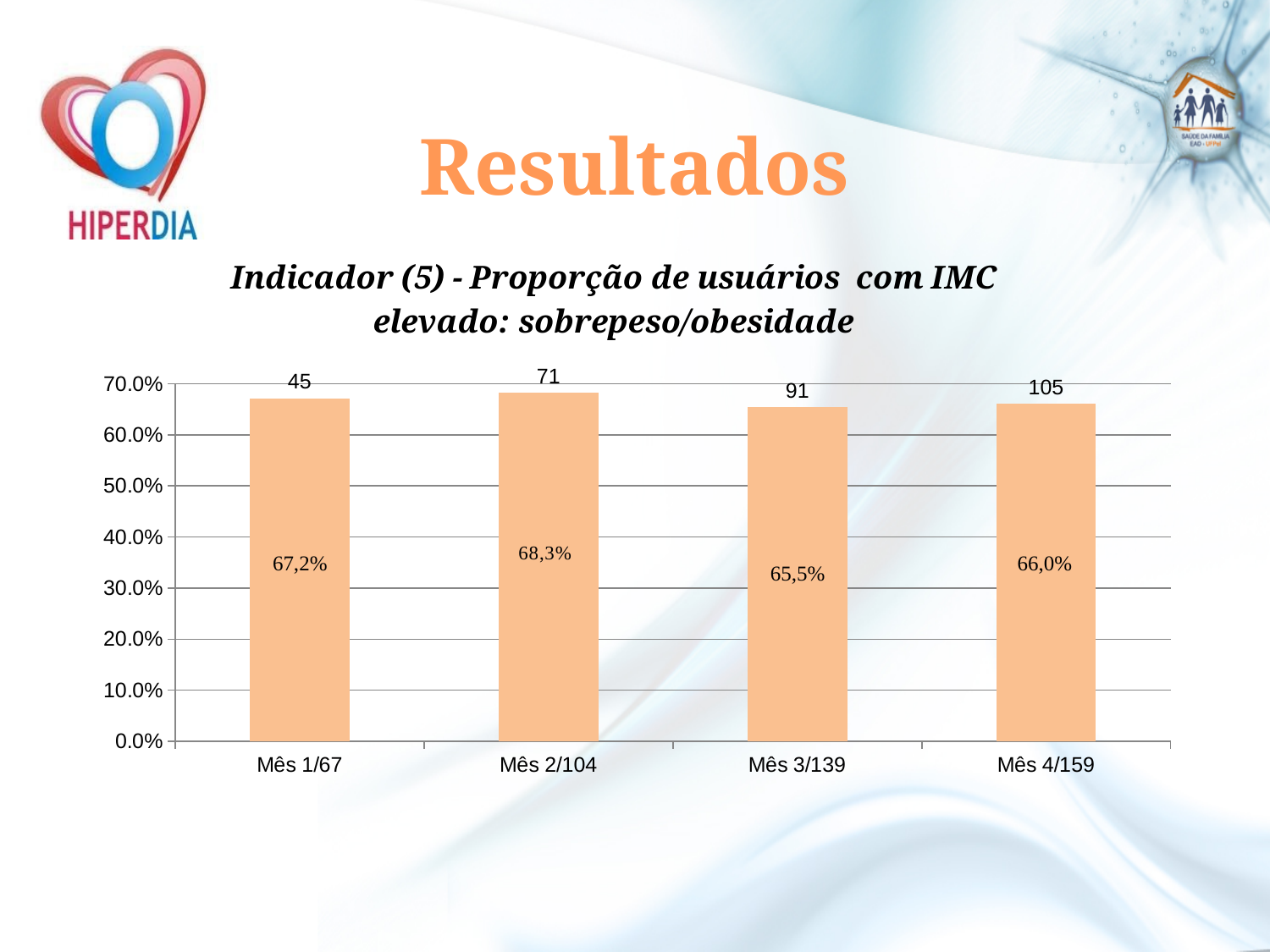
What number is printed above the bar for Mês 2/104? 71 What is the percentage value shown for Mês 1/67? 67,2% What is the difference between the percentage for Mês 2/104 and Mês 1/67? 1,1 percentage points Which is larger, the percentage for Mês 1/67 or for Mês 4/159? Mês 1/67 What kind of chart is shown on the slide? Bar chart What is the title of the chart? Indicador (5) - Proporção de usuários com IMC elevado: sobrepeso/obesidade Which month has the highest percentage? Mês 2/104 How many bars are shown in the chart? 4 What number is printed above the bar for Mês 4/159? 105 What is the percentage value shown for Mês 3/139? 65,5% Which month has the lowest percentage? Mês 3/139 Is the value for Mês 3/139 greater or less than 60.0%? greater